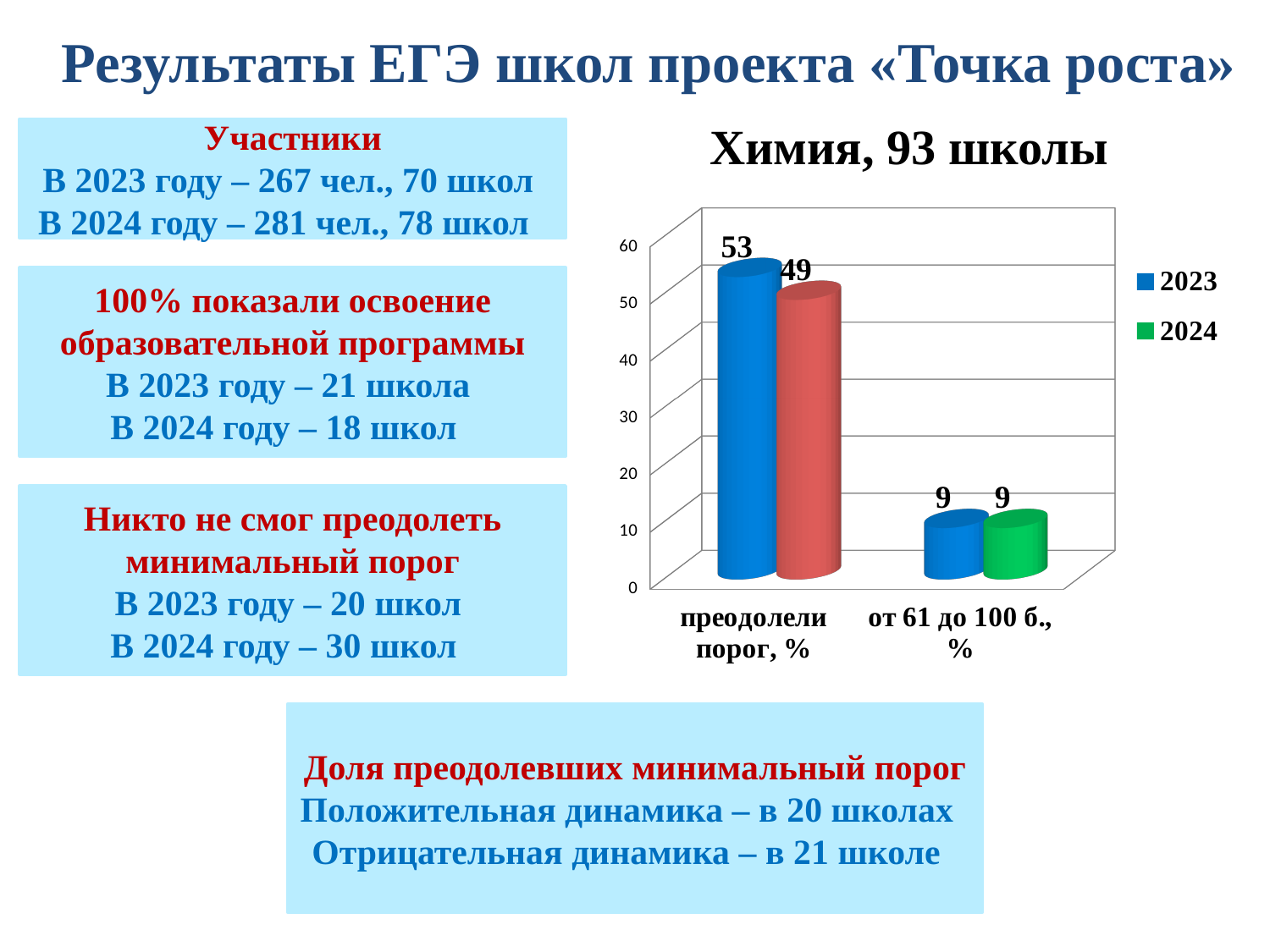
What is the value for 2023 in the category "от 61 до 100 б., %"? 9 How many categories are shown on the x axis of the chart? 2 Which series does the legend list first? 2023 What is the value for 2023 in the category "преодолели порог, %"? 53 How many series does the chart legend list? 2 What is the value for 2024 in the category "от 61 до 100 б., %"? 9 What type of chart is shown on the slide? bar chart What is the value for 2024 in the category "преодолели порог, %"? 49 Which category has the highest value in the chart? преодолели порог, % Which is larger in the category "преодолели порог, %": the 2023 value or the 2024 value? 2023 What is the difference between the 2023 and 2024 values in the category "преодолели порог, %"? 4 What is the title of the chart? Химия, 93 школы